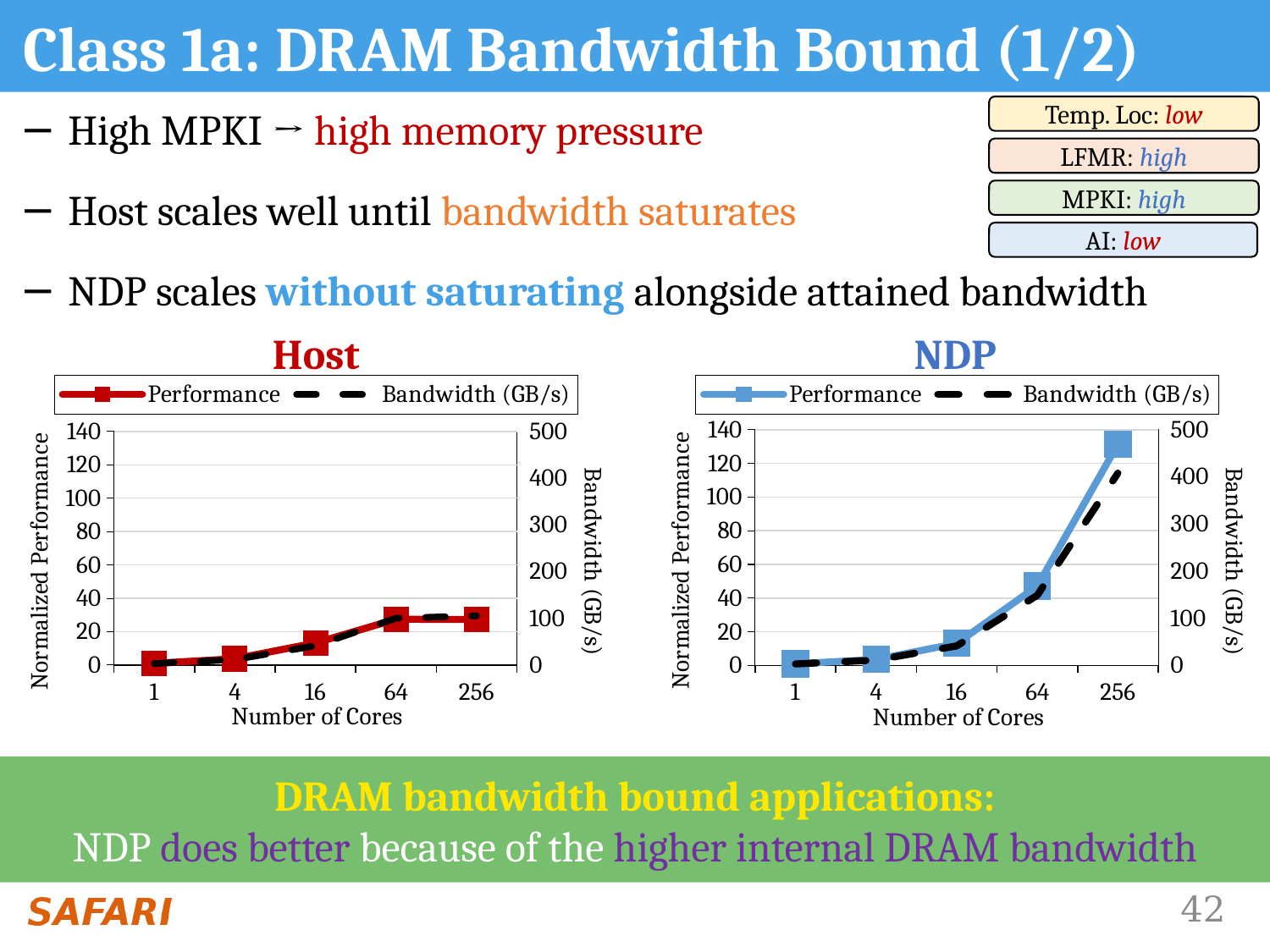
In the NDP chart, is the Performance value at 64 cores greater or less than 40? greater In the Host chart, is the Performance value at 256 cores greater or less than 40? less What kind of chart is the Host chart? line chart At 256 cores, which chart shows the larger Performance value, Host or NDP? NDP In the NDP chart, at which number of cores is Performance lowest? 1 In the NDP chart, does Performance rise or fall as the number of cores increases? rise In the Host chart, is the Performance value at 16 cores greater or less than 20? less In the NDP chart, at which number of cores is Performance highest? 256 How many series does the legend of the NDP chart list? 2 How many core counts are plotted along the x axis of the Host chart? 5 What is the label of the right-hand y axis in the Host chart? Bandwidth (GB/s)